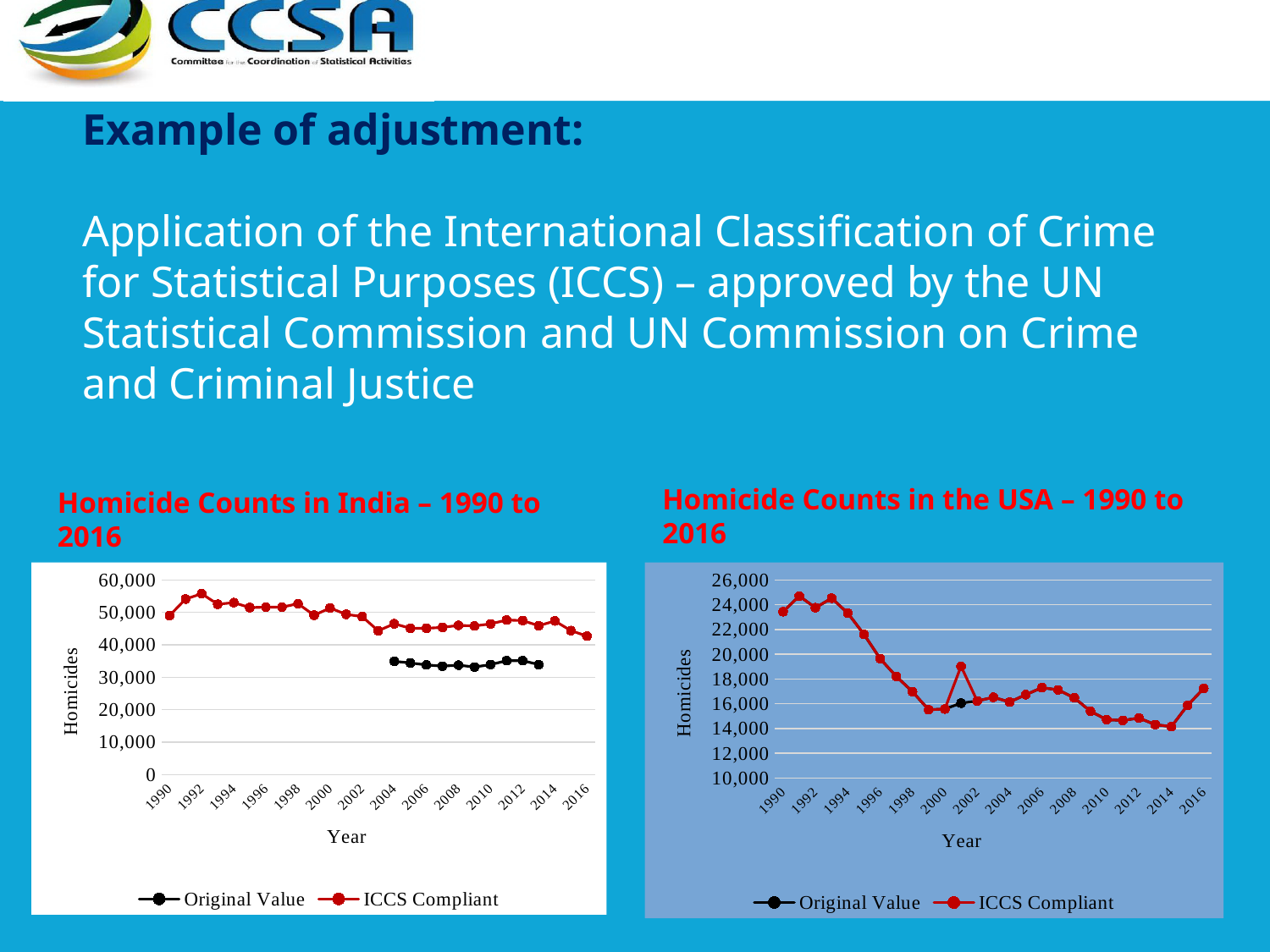
In the 'Homicide Counts in India – 1990 to 2016' chart, is the ICCS Compliant value for 1992 greater or less than 50,000? greater In the 'Homicide Counts in India – 1990 to 2016' chart, is the Original Value for 2004 greater or less than 40,000? less In the 'Homicide Counts in India – 1990 to 2016' chart, is the ICCS Compliant value for 2016 greater or less than 50,000? less In the 'Homicide Counts in the USA – 1990 to 2016' chart, which series is drawn in red? ICCS Compliant In the 'Homicide Counts in the USA – 1990 to 2016' chart, which is larger for the ICCS Compliant series: the value for 1990 or the value for 2014? 1990 What kind of chart is the 'Homicide Counts in India – 1990 to 2016' chart? line chart In the 'Homicide Counts in India – 1990 to 2016' chart, which series has the larger value in 2010: Original Value or ICCS Compliant? ICCS Compliant How many series does the legend of the 'Homicide Counts in the USA – 1990 to 2016' chart list? 2 In the 'Homicide Counts in the USA – 1990 to 2016' chart, does the ICCS Compliant series generally rise or fall from 1990 to 2014? fall In the 'Homicide Counts in India – 1990 to 2016' chart, what is the label of the vertical axis? Homicides